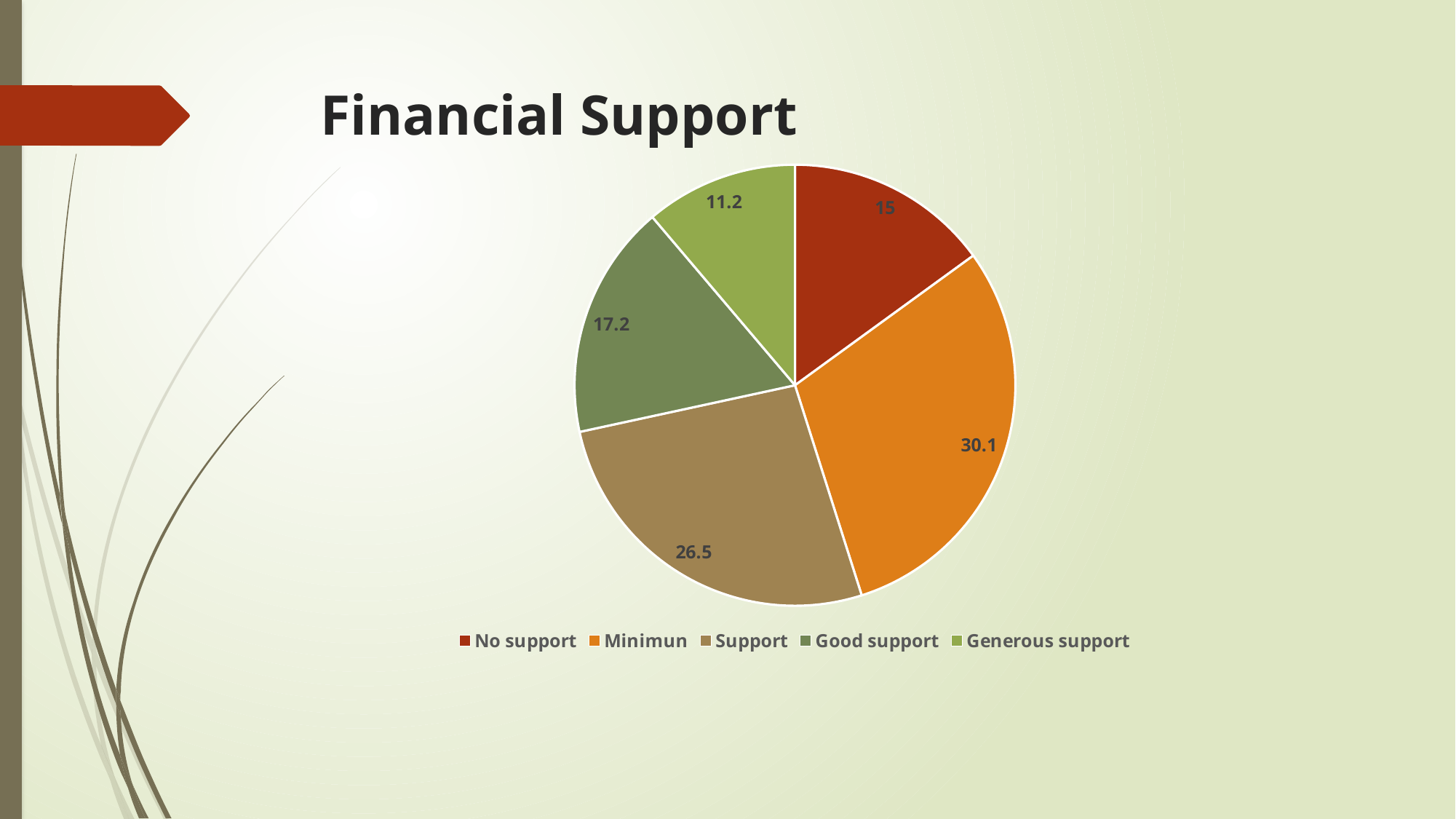
Which is larger, the No support slice or the Good support slice? Good support What share of the pie does the Support slice represent? 26.5 What is the title of the chart? Financial Support What is the value for the Minimun slice? 30.1 Which category has the largest slice of the pie? Minimun How many slices does the pie chart have? 5 What kind of chart is shown on the slide? Pie chart What is the value for the Good support slice? 17.2 What is the difference between the Good support and Generous support values? 6 Which category has the smallest slice of the pie? Generous support What is the value for the No support slice? 15 What is the difference between the Minimun and Support values? 3.6